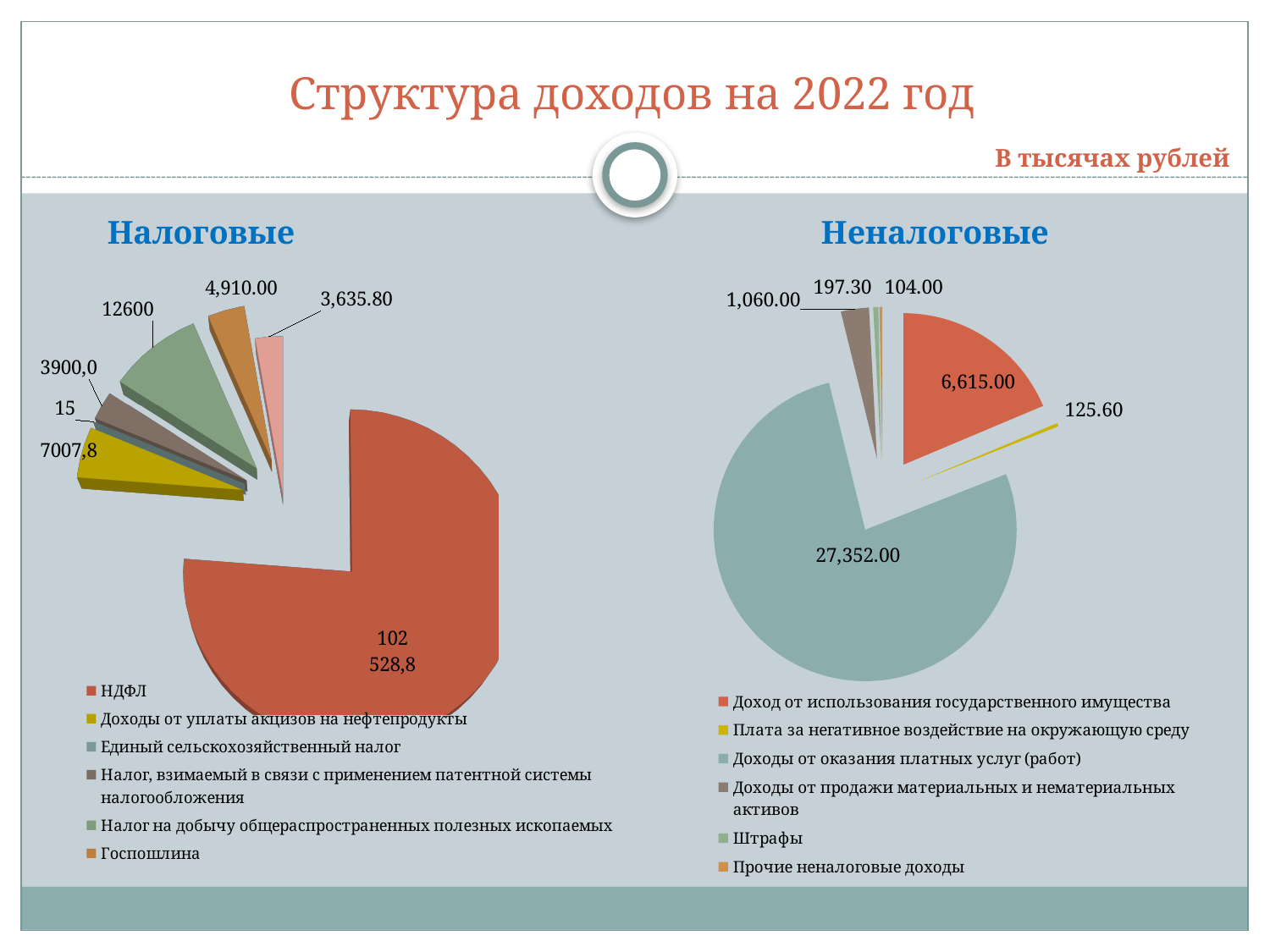
What type of chart is the 'Неналоговые' chart? Pie chart On the 'Неналоговые' chart, which category has the smallest value? Прочие неналоговые доходы On the 'Налоговые' chart, what is the value for НДФЛ? 102 528,8 On the 'Налоговые' chart, which category has the smallest value? Единый сельскохозяйственный налог On the 'Неналоговые' chart, what is the value for Доходы от оказания платных услуг (работ)? 27,352.00 On the 'Налоговые' chart, what is the value for Госпошлина? 4,910.00 On the 'Неналоговые' chart, which is larger: Доходы от продажи материальных и нематериальных активов or Штрафы? Доходы от продажи материальных и нематериальных активов On the 'Неналоговые' chart, what is the difference between Доход от использования государственного имущества and Плата за негативное воздействие на окружающую среду? 6,489.40 On the 'Неналоговые' chart, what is the value for Штрафы? 197.30 On the 'Налоговые' chart, how many entries does the legend list? 6 On the 'Налоговые' chart, what is the value for Налог на добычу общераспространенных полезных ископаемых? 12600 On the 'Налоговые' chart, which category has the largest value? НДФЛ